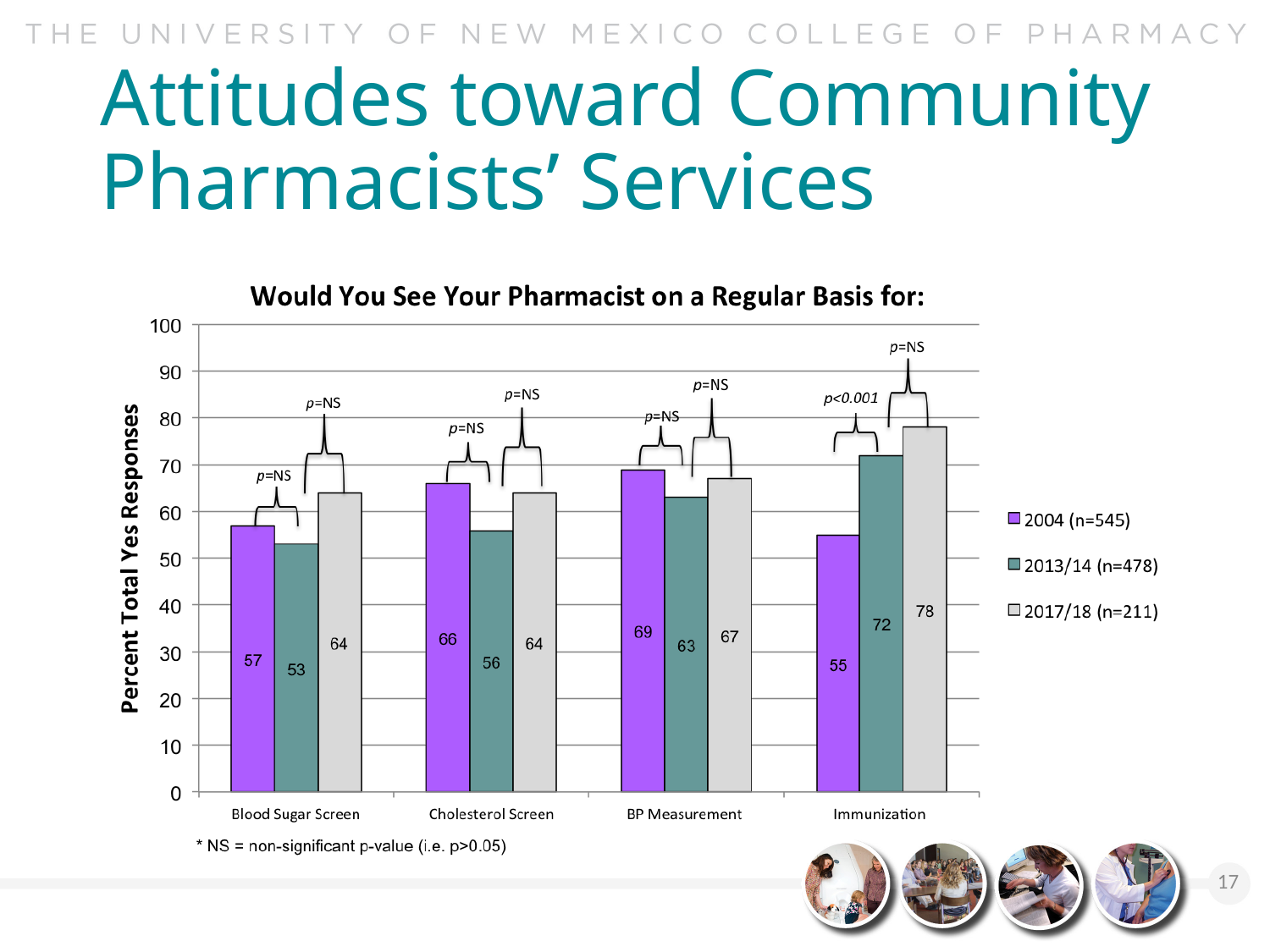
How many series does the legend list? 3 Which category has the lowest value in the 2004 (n=545) series? Immunization Which is larger for Cholesterol Screen: the 2004 (n=545) value or the 2013/14 (n=478) value? 2004 (n=545) What is the value for Immunization in the 2017/18 (n=211) series? 78 What is the difference between the 2017/18 (n=211) and 2004 (n=545) values for Immunization? 23 What kind of chart is shown on the slide? bar chart What is the title of the chart? Would You See Your Pharmacist on a Regular Basis for: How many categories are shown on the x axis? 4 Which category has the highest value in the 2017/18 (n=211) series? Immunization What is the value for BP Measurement in the 2004 (n=545) series? 69 Is the value for BP Measurement in the 2013/14 (n=478) series greater or less than 60? greater What is the value for Blood Sugar Screen in the 2013/14 (n=478) series? 53